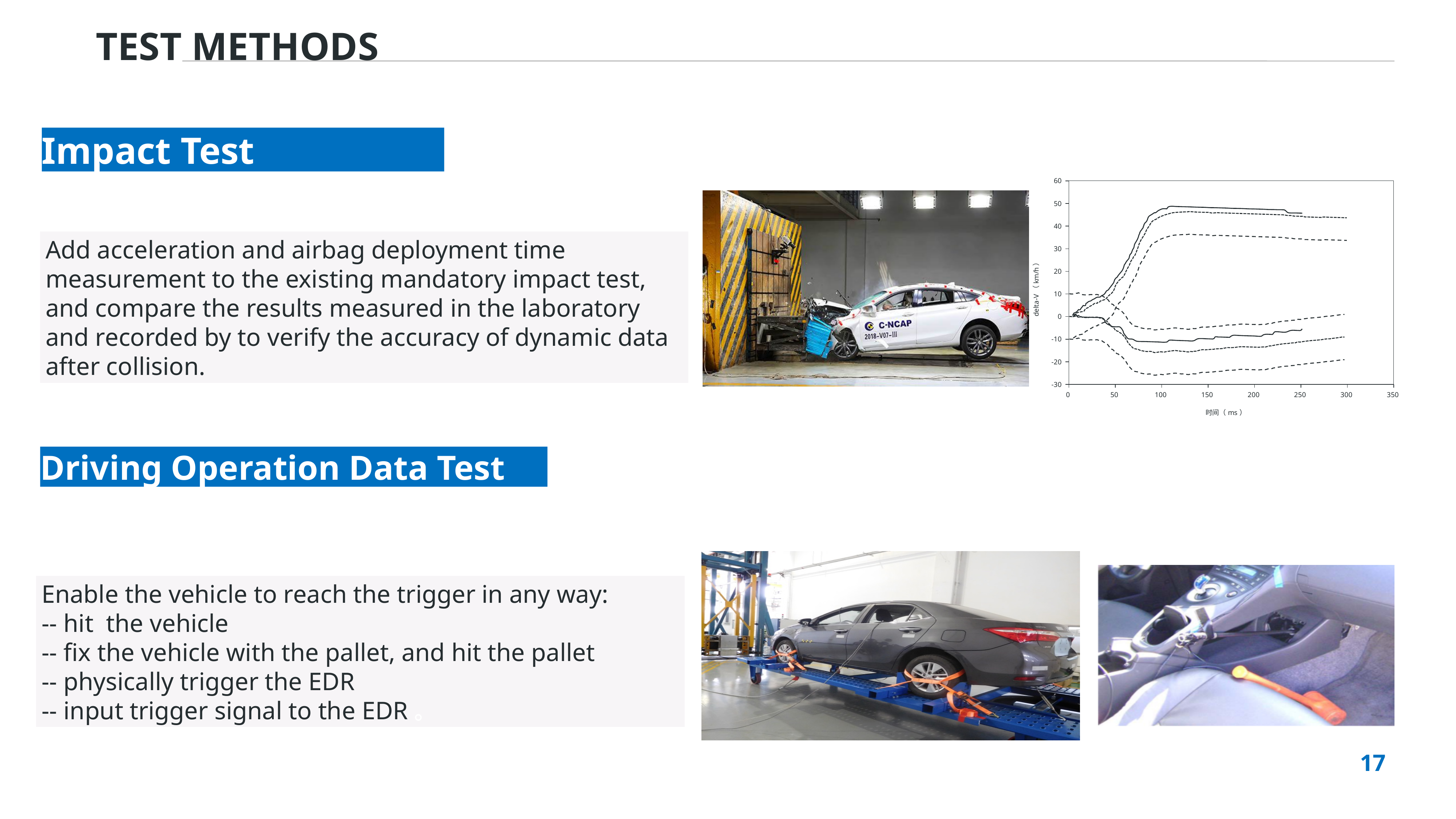
In the line chart, is the value of the topmost curve at 300 ms greater or less than 30? greater In the line chart, is the value of the lowest curve at 100 ms greater or less than -20? less What kind of chart is shown on the right of the Impact Test section? line chart In the line chart, do the upper curves rise or fall between 0 ms and 100 ms? rise What is the label of the y axis of the line chart? delta-V（km/h） In the line chart, is the value of the topmost curve at 100 ms greater or less than 40? greater What is the label of the x axis of the line chart? 时间（ms） In the line chart, does the lowest curve rise or fall between 0 ms and 100 ms? fall